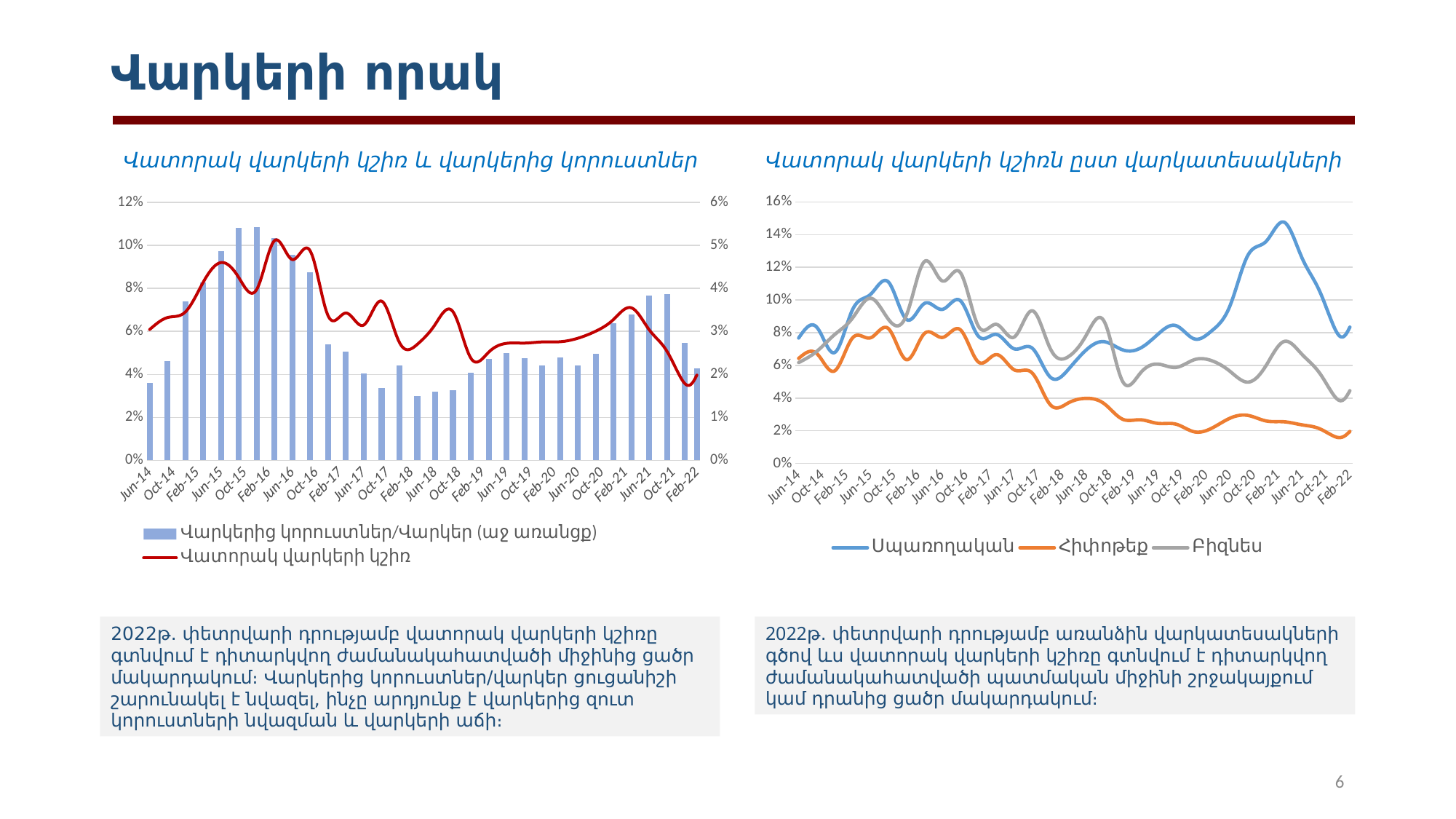
How many series does the legend of the right chart ("Վատորակ վարկերի կշիռն ըստ վարկատեսակների") list? 3 In the right chart ("Վատորակ վարկերի կշիռն ըստ վարկատեսակների"), is the Սպառողական value for Feb-21 greater or less than 14%? greater In the left chart ("Վատորակ վարկերի կշիռ և վարկերից կորուստներ"), is the bar value for Jun-14 greater or less than 4%? less In the right chart ("Վատորակ վարկերի կշիռն ըստ վարկատեսակների"), which series has the lowest value at Feb-22? Հիփոթեք In the left chart ("Վատորակ վարկերի կշիռ և վարկերից կորուստներ"), how many bars are plotted? 31 In the right chart ("Վատորակ վարկերի կշիռն ըստ վարկատեսակների"), is the Հիփոթեք value for Feb-18 greater or less than 4%? less How many series does the legend of the left chart ("Վատորակ վարկերի կշիռ և վարկերից կորուստներ") list? 2 In the right chart ("Վատորակ վարկերի կշիռն ըստ վարկատեսակների"), which series has the highest value at Feb-21? Սպառողական What kind of chart is the right chart, titled "Վատորակ վարկերի կշիռն ըստ վարկատեսակների"? line chart In the right chart ("Վատորակ վարկերի կշիռն ըստ վարկատեսակների"), which colour is used for the Հիփոթեք series? orange